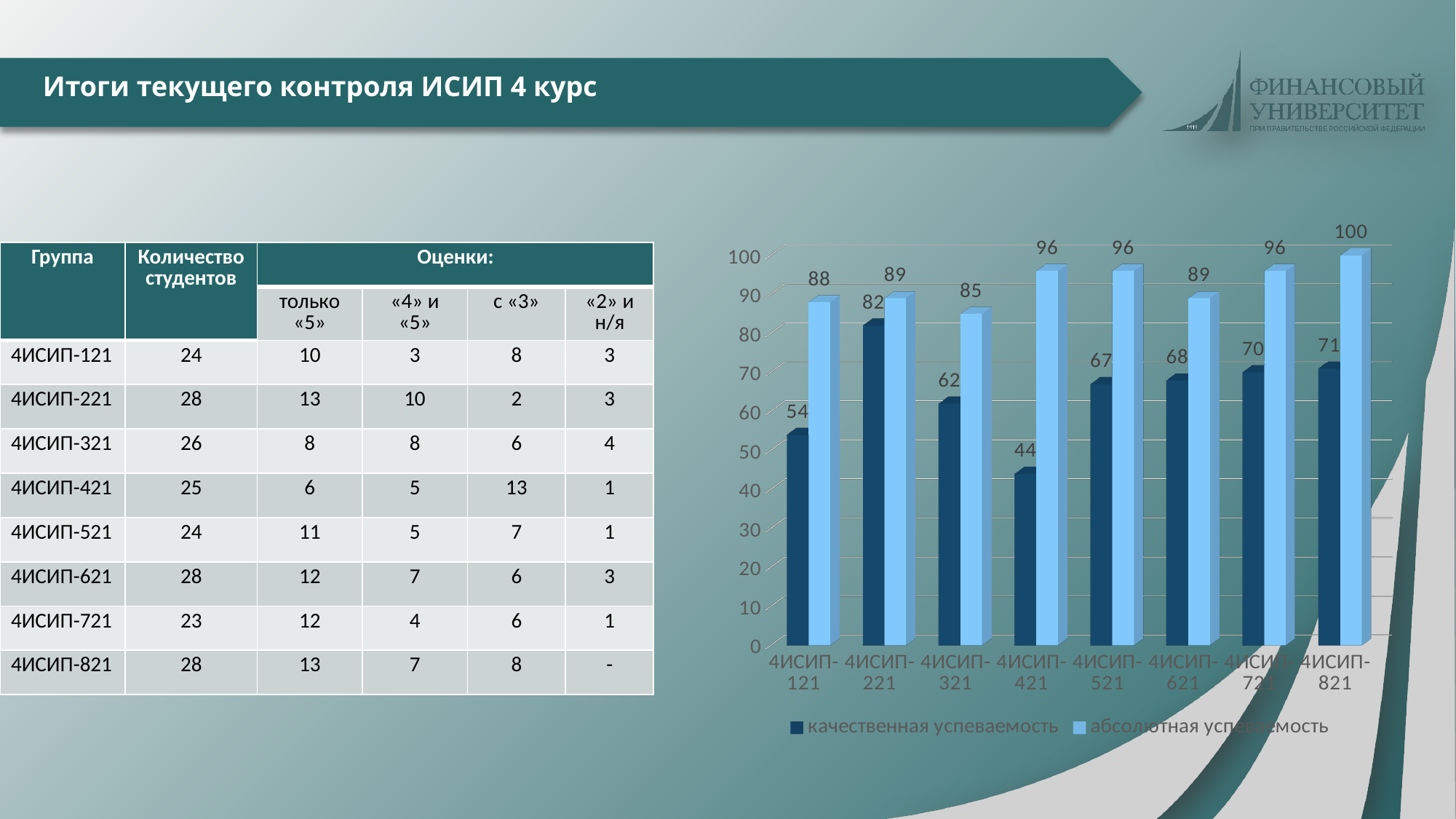
Which group has the lowest качественная успеваемость? 4ИСИП-421 How many groups are shown on the x axis of the chart? 8 What is the value of абсолютная успеваемость for 4ИСИП-821? 100 What kind of chart is shown on the slide? bar chart What is the value of качественная успеваемость for 4ИСИП-421? 44 What is the value of качественная успеваемость for 4ИСИП-221? 82 What is the difference between абсолютная успеваемость and качественная успеваемость for 4ИСИП-421? 52 How many series does the chart legend list? 2 Is the value of качественная успеваемость for 4ИСИП-521 greater or less than 60? greater Which is larger: качественная успеваемость for 4ИСИП-121 or for 4ИСИП-321? 4ИСИП-321 Which series is shown in dark blue in the chart? качественная успеваемость Which group has the highest абсолютная успеваемость? 4ИСИП-821